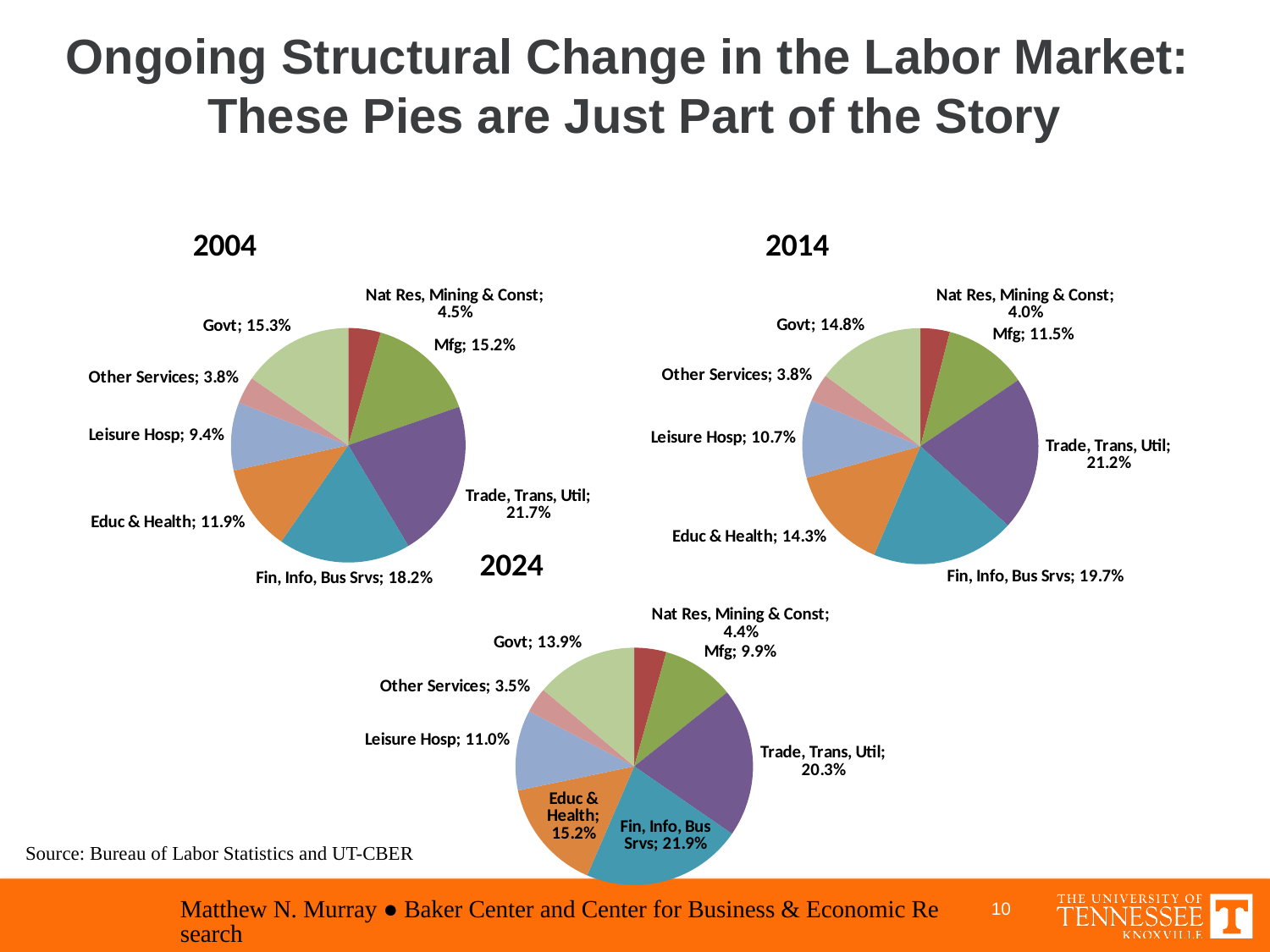
What type of chart is used for the 2014 data? Pie chart How many categories are shown in the 2004 pie chart? 8 In the 2004 pie chart, which category has the largest share? Trade, Trans, Util In the 2024 pie chart, what share does Fin, Info, Bus Srvs have? 21.9% In the 2014 pie chart, which is larger: the share for Govt or the share for Mfg? Govt How many pie charts are shown on the slide? 3 In the 2024 pie chart, which category has the smallest share? Other Services In the 2004 pie chart, what share does Trade, Trans, Util have? 21.7% What is the difference between the Mfg share in the 2004 pie chart and the Mfg share in the 2024 pie chart? 5.3% In the 2014 pie chart, what share does Educ & Health have? 14.3% In the 2024 pie chart, which category has the largest share? Fin, Info, Bus Srvs In the 2014 pie chart, which category has the smallest share? Other Services